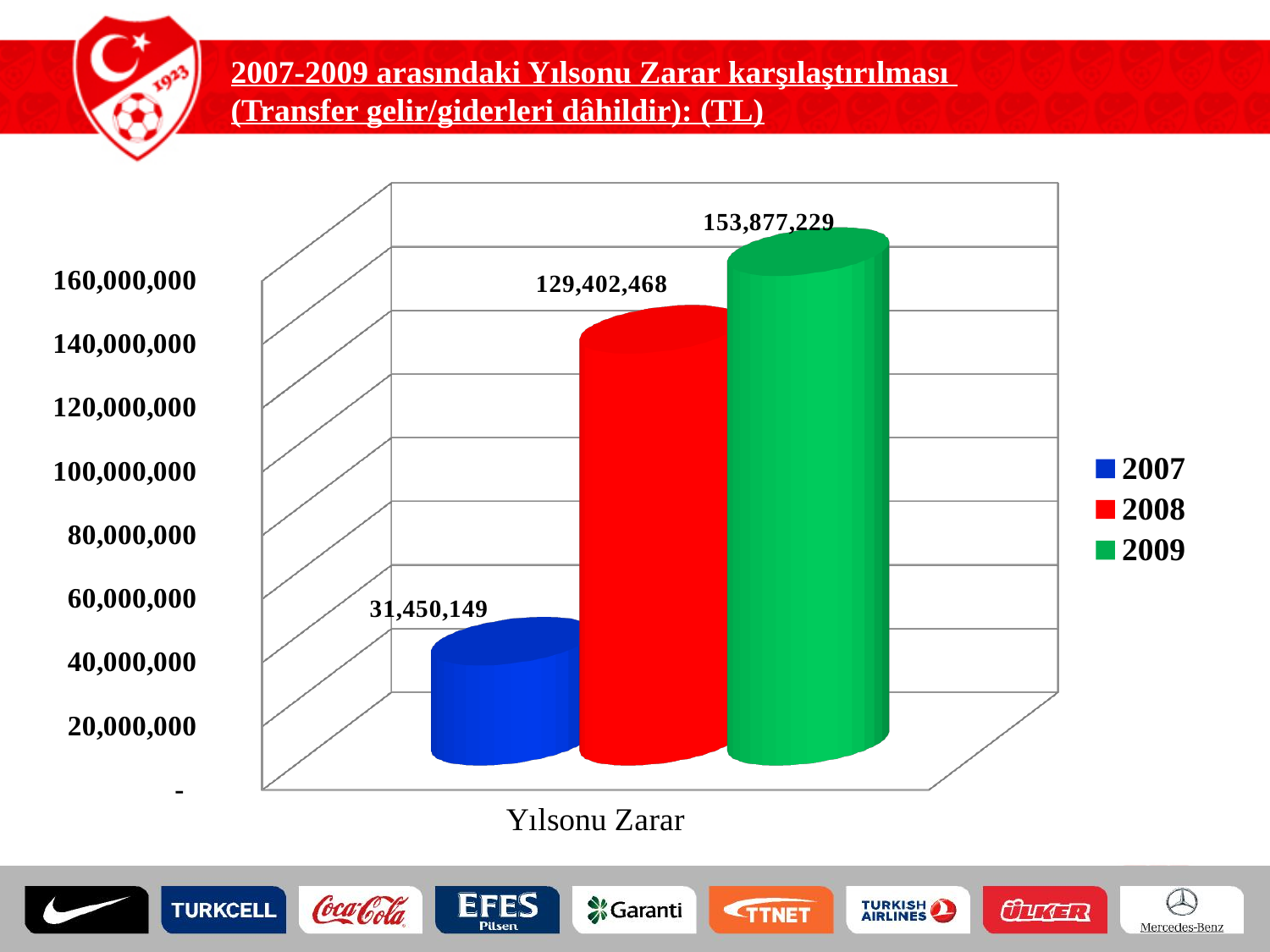
What is the value for 2007 in the Yılsonu Zarar chart? 31,450,149 Is the value for 2007 greater or less than 40,000,000? less Which colour represents 2008 in the legend? red How many series does the legend list? 3 Which year has the highest Yılsonu Zarar value? 2009 Which is larger, the value for 2008 or the value for 2009? 2009 What kind of chart is shown on the slide? bar chart What is the value for 2009 in the Yılsonu Zarar chart? 153,877,229 What is the difference between the 2009 and 2008 values? 24,474,761 Which year has the lowest Yılsonu Zarar value? 2007 What is the difference between the 2008 and 2007 values? 97,952,319 What is the value for 2008 in the Yılsonu Zarar chart? 129,402,468